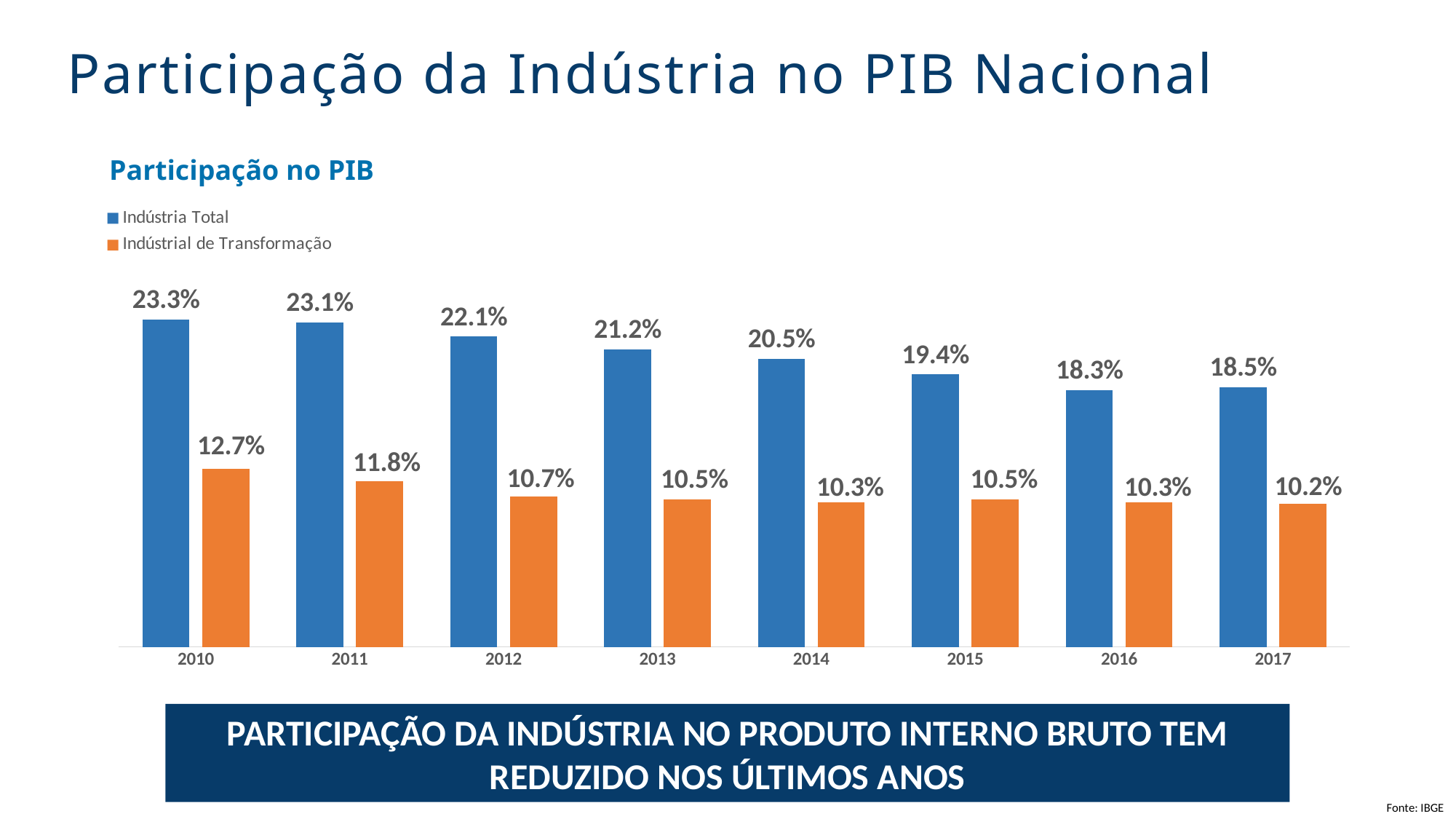
What is the value for Indústria Total in 2010? 23.3% What is the value for Industrial de Transformação in 2017? 10.2% How many years are shown on the x axis? 8 What is the difference between Indústria Total in 2010 and in 2017? 4.8% What kind of chart is shown? Bar chart What is the title of the chart? Participação no PIB In which year is Indústria Total lowest? 2016 How many series does the legend list? 2 What is the value for Industrial de Transformação in 2013? 10.5% In which year is Indústria Total highest? 2010 What is the difference between Indústria Total and Industrial de Transformação in 2010? 10.6% Which is larger, Indústria Total in 2016 or in 2017? 2017